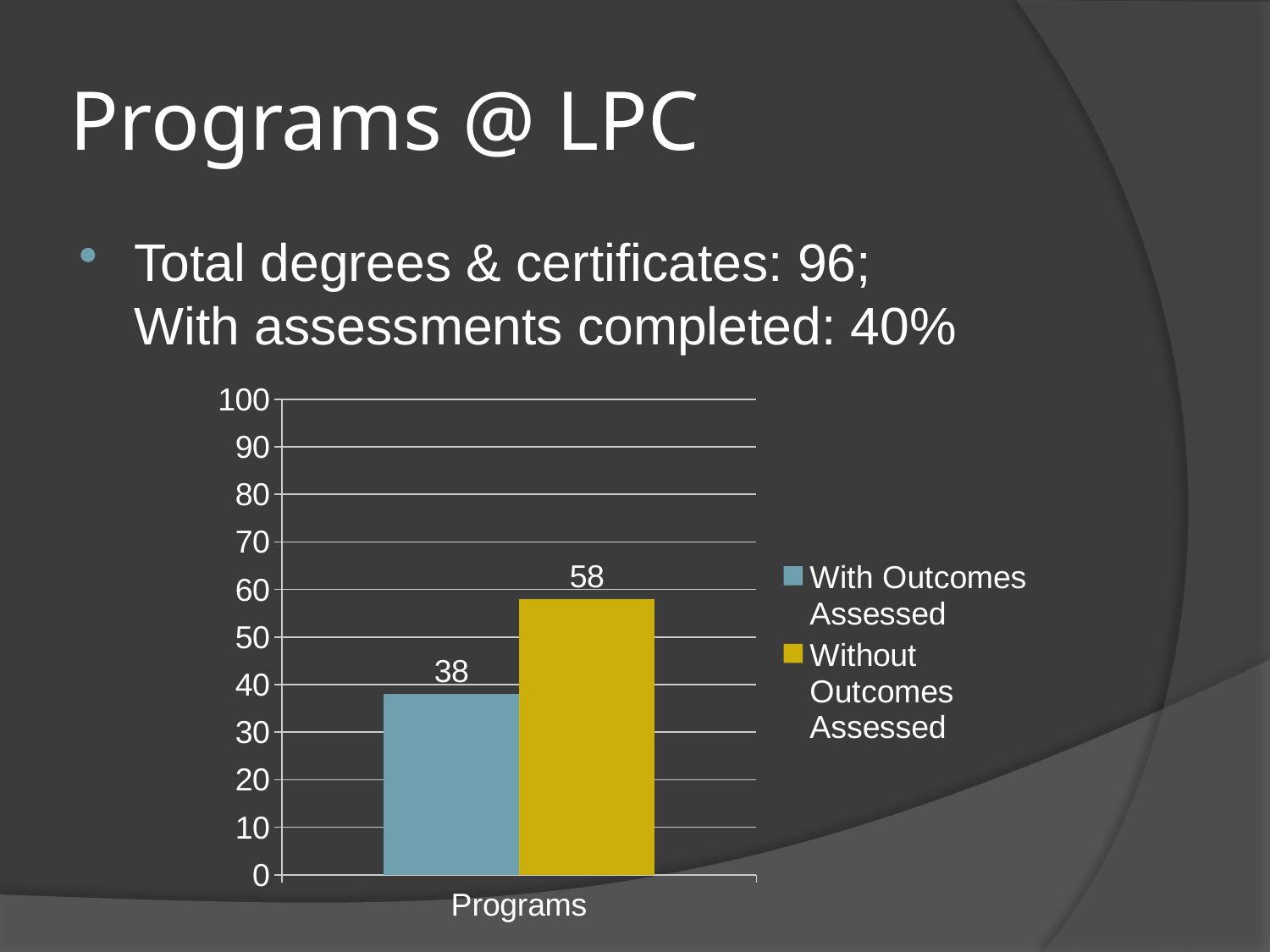
Is the value for With Outcomes Assessed greater or less than 40? less What is the value for Without Outcomes Assessed? 58 Is the value for Without Outcomes Assessed greater or less than 50? greater What is the difference between the Without Outcomes Assessed and With Outcomes Assessed values? 20 What is the sum of the two bar values? 96 What kind of chart is shown on the slide? bar chart Which series has the higher value, With Outcomes Assessed or Without Outcomes Assessed? Without Outcomes Assessed Which series has the lowest value? With Outcomes Assessed What is the value for With Outcomes Assessed? 38 What is the maximum value shown on the y axis? 100 How many series does the legend list? 2 What is the category label on the x axis? Programs